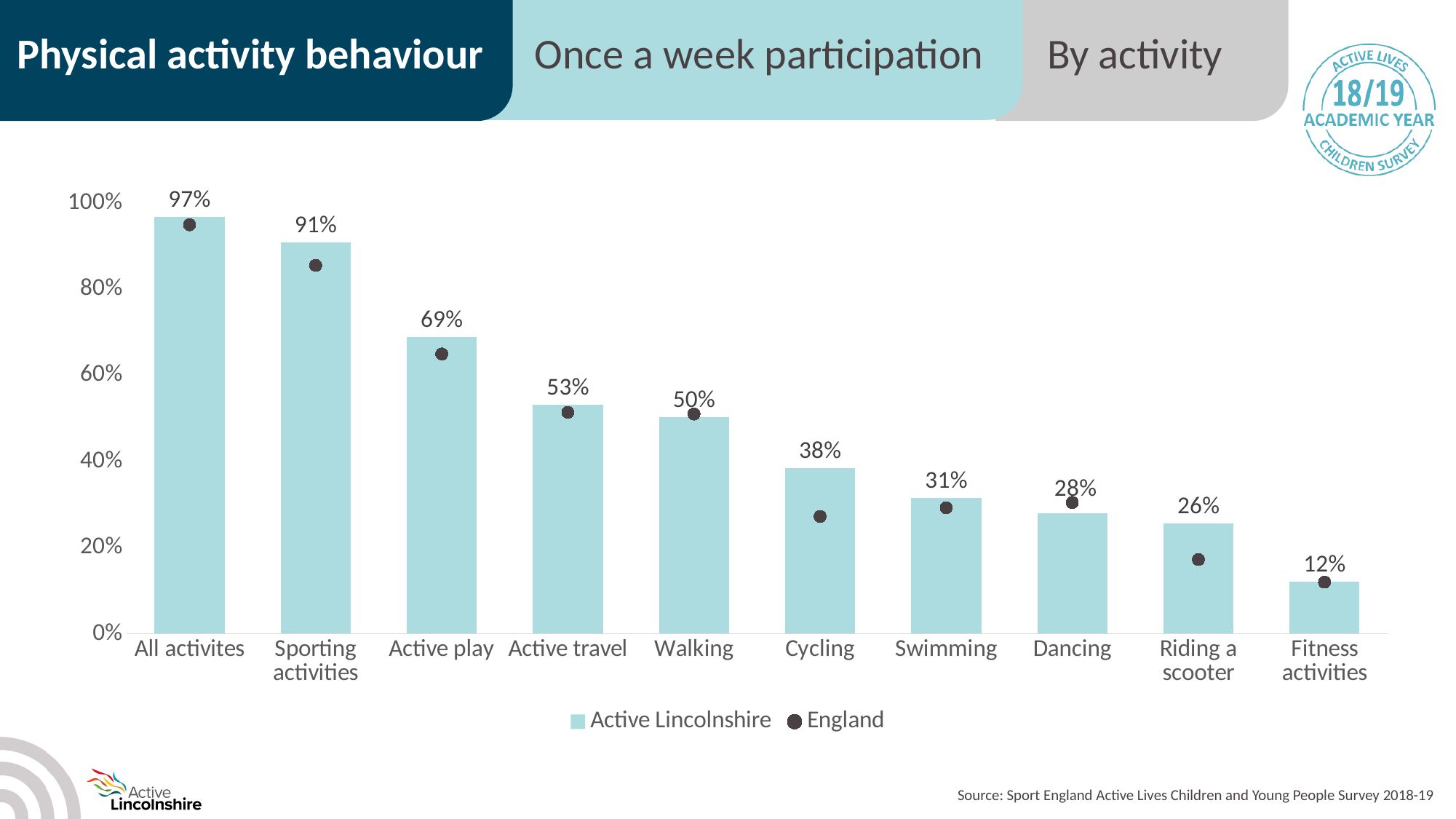
Which activity has the highest Active Lincolnshire value? All activites How many series does the legend list? 2 What is the Active Lincolnshire value for Active play? 69% Is the England value for Sporting activities greater or less than 80%? greater Do the Active Lincolnshire values rise or fall from left to right along the x axis? fall Which activity has the lowest Active Lincolnshire value? Fitness activities What is the difference between the Active Lincolnshire values for Sporting activities and Active play? 22% How many activities are shown on the x axis? 10 What is the Active Lincolnshire value for Cycling? 38% Which has a larger Active Lincolnshire value, Swimming or Dancing? Swimming What is the Active Lincolnshire value for Riding a scooter? 26% Is the England value for Cycling greater or less than 40%? less